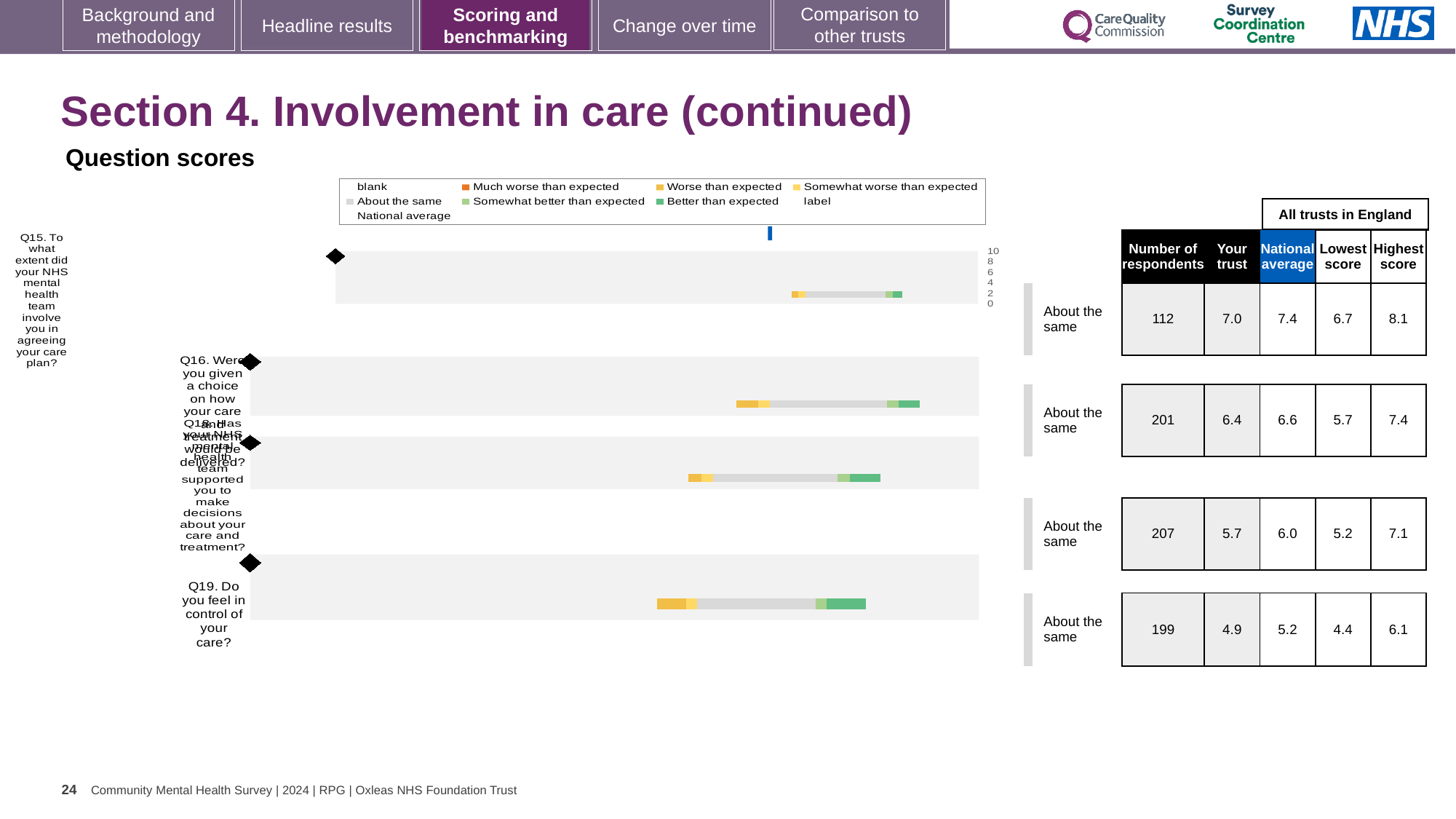
How many respondents answered Q16 (Were you given a choice on how your care and treatment would be delivered?)? 201 What kind of chart is used to show the question scores on this slide? bar chart For Q16, how much higher is the national average (6.6) than the 'Your trust' score (6.4)? 0.2 What is the national average score for Q15 (involvement in agreeing your care plan)? 7.4 How many questions (categories) are plotted in the question scores chart? 4 For Q18, which is larger: the 'Your trust' score or the national average? National average What is the 'Your trust' score for Q19 (Do you feel in control of your care?)? 4.9 Which question has the highest 'Your trust' score? Q15 What is the highest score among all trusts in England for Q19? 6.1 What benchmark category is shown for Q16? About the same What is the difference between the highest score (8.1) and the lowest score (6.7) for Q15? 1.4 Which question has the lowest 'Your trust' score? Q19